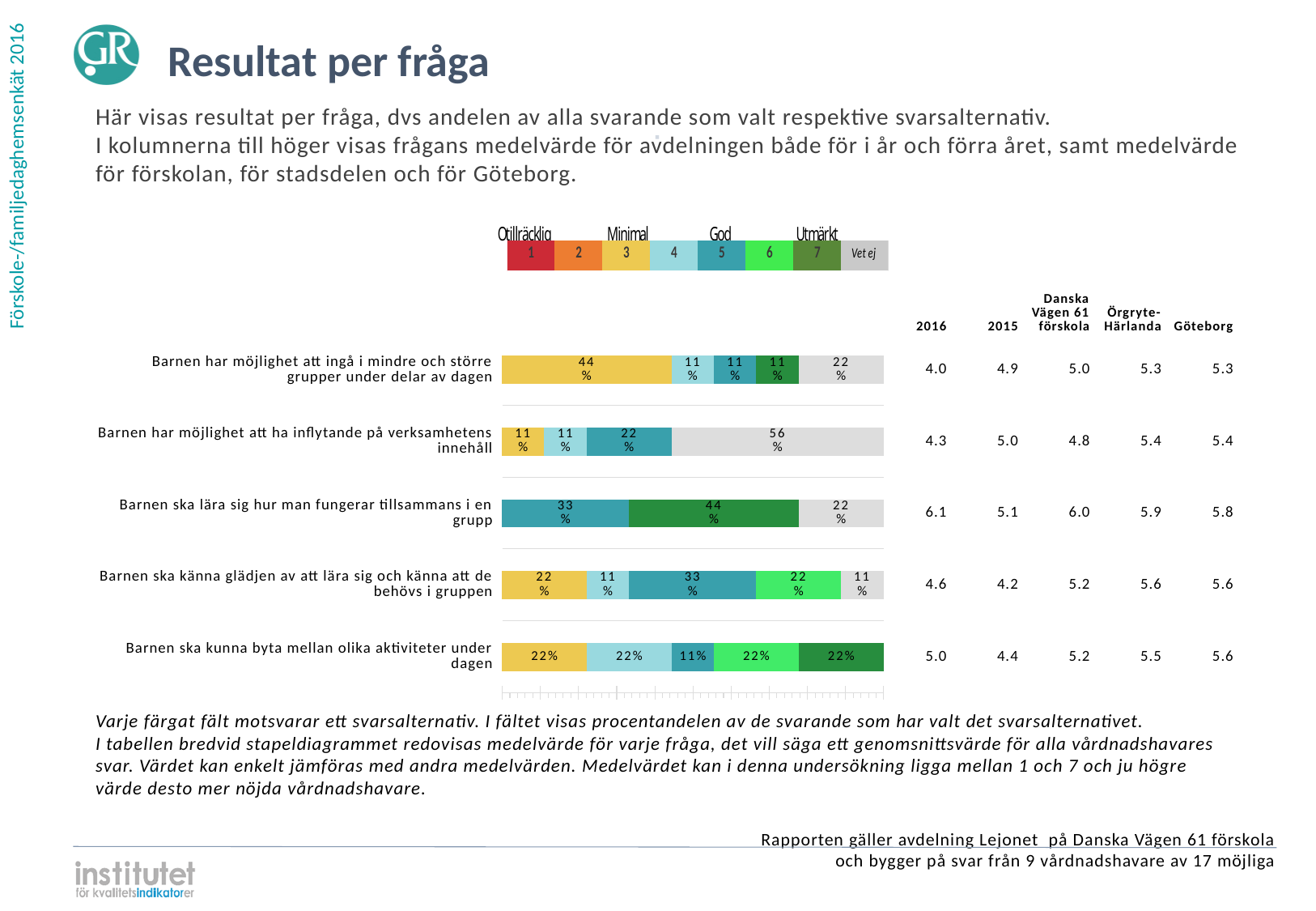
What label does the legend give to response options 1 and 2 (red and orange)? Otillräcklig Which response option has the largest share for 'Barnen ska lära sig hur man fungerar tillsammans i en grupp'? 7 What percentage chose option 7 (dark green) for 'Barnen ska lära sig hur man fungerar tillsammans i en grupp'? 44% How many questions (bars) are plotted in the chart? 5 How many response options does the legend above the chart list? 8 What percentage chose option 5 (teal) for 'Barnen ska känna glädjen av att lära sig och känna att de behövs i gruppen'? 33% What percentage of respondents chose 'Vet ej' for 'Barnen har möjlighet att ha inflytande på verksamhetens innehåll'? 56% What is the 2016 mean value shown for 'Barnen ska lära sig hur man fungerar tillsammans i en grupp'? 6.1 For 'Barnen ska lära sig hur man fungerar tillsammans i en grupp', which is larger: the share for option 5 or the share for option 7? Option 7 What kind of chart is shown on the slide? Stacked bar chart What percentage chose option 3 (yellow) for 'Barnen har möjlighet att ingå i mindre och större grupper under delar av dagen'? 44% For 'Barnen ska lära sig hur man fungerar tillsammans i en grupp', what is the difference between the option 7 share and the option 5 share? 11%